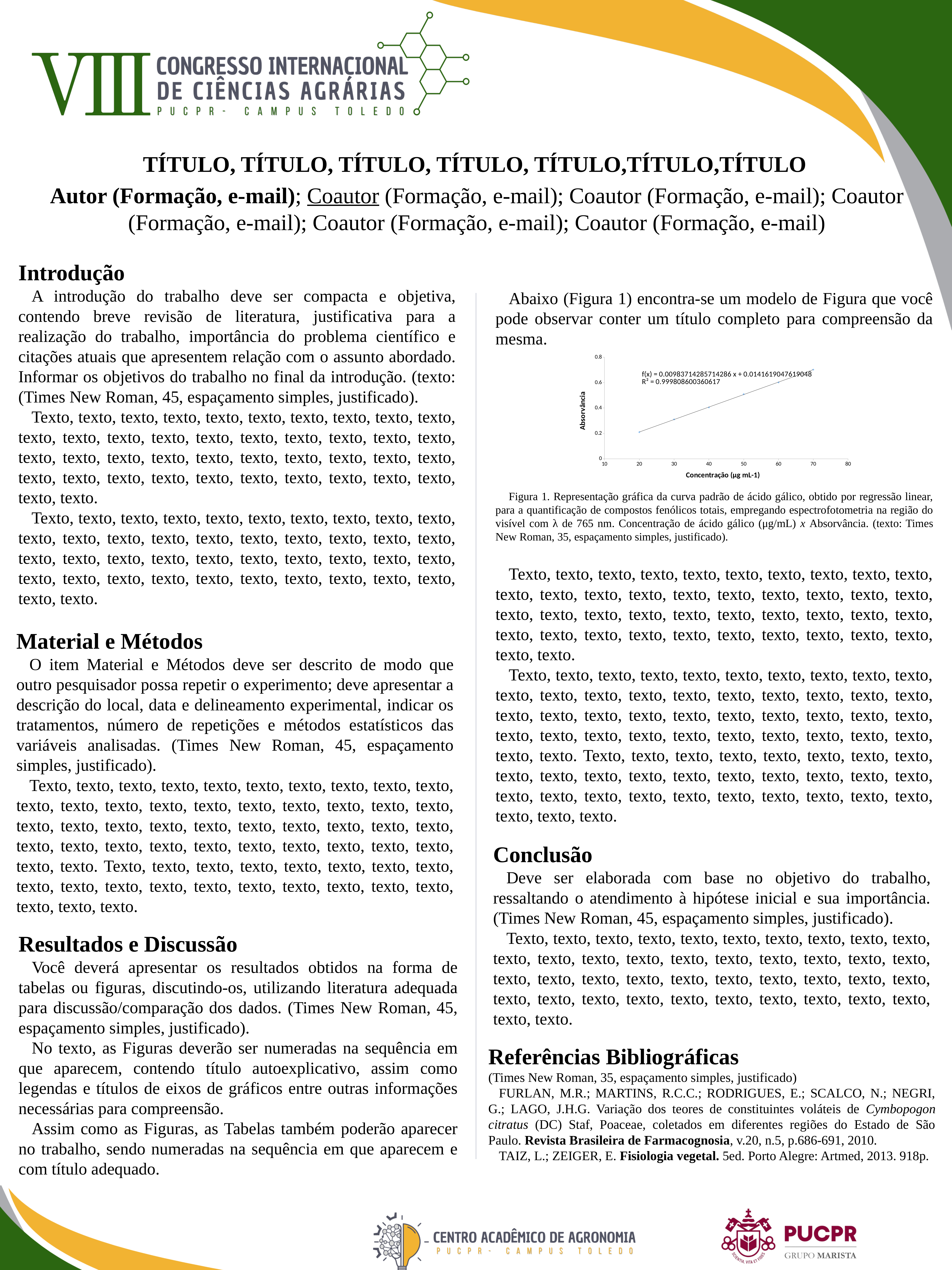
Which plotted concentration has the lowest absorbance? 20 Is the absorbance value at a concentration of 60 greater or less than 0.4? greater Is the absorbance value at a concentration of 70 greater or less than 0.6? greater Is the absorbance value at a concentration of 30 greater or less than 0.6? less What is the title of the x axis of the chart? Concentração (µg mL-1) How many data points are plotted in the chart? 6 Which plotted concentration has the highest absorbance? 70 What kind of chart is shown in Figura 1? scatter chart What is the title of the y axis of the chart? Absorvância Do the absorbance values rise or fall as concentration increases along the x axis? rise Which has the larger absorbance, the point at concentration 40 or the point at concentration 60? 60